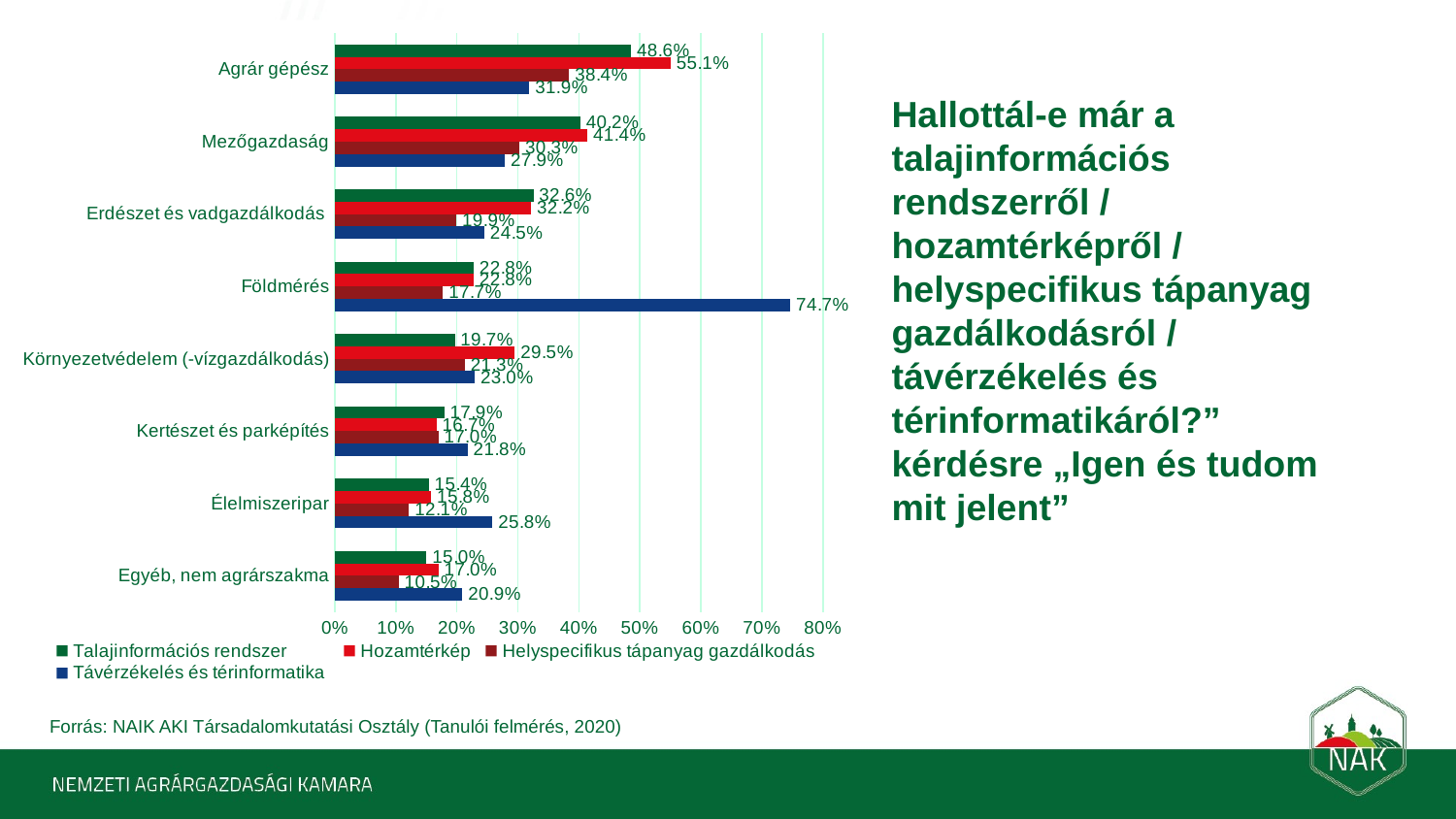
How many categories are shown on the chart? 8 Which category has the highest value for the Talajinformációs rendszer series? Agrár gépész Which category has the highest value for the Távérzékelés és térinformatika series? Földmérés Is the value for Távérzékelés és térinformatika in the Földmérés category greater or less than 70%? greater In the Agrár gépész category, how much higher is the Hozamtérkép value than the Talajinformációs rendszer value? 6.5 percentage points What is the value for Távérzékelés és térinformatika in the Földmérés category? 74.7% Which category has the lowest value for the Helyspecifikus tápanyag gazdálkodás series? Egyéb, nem agrárszakma In the Élelmiszeripar category, which is larger: Távérzékelés és térinformatika or Talajinformációs rendszer? Távérzékelés és térinformatika What colour represents the Távérzékelés és térinformatika series? Dark blue How many series does the legend list? 4 What kind of chart is shown on the slide? Bar chart What is the value for Hozamtérkép in the Agrár gépész category? 55.1%